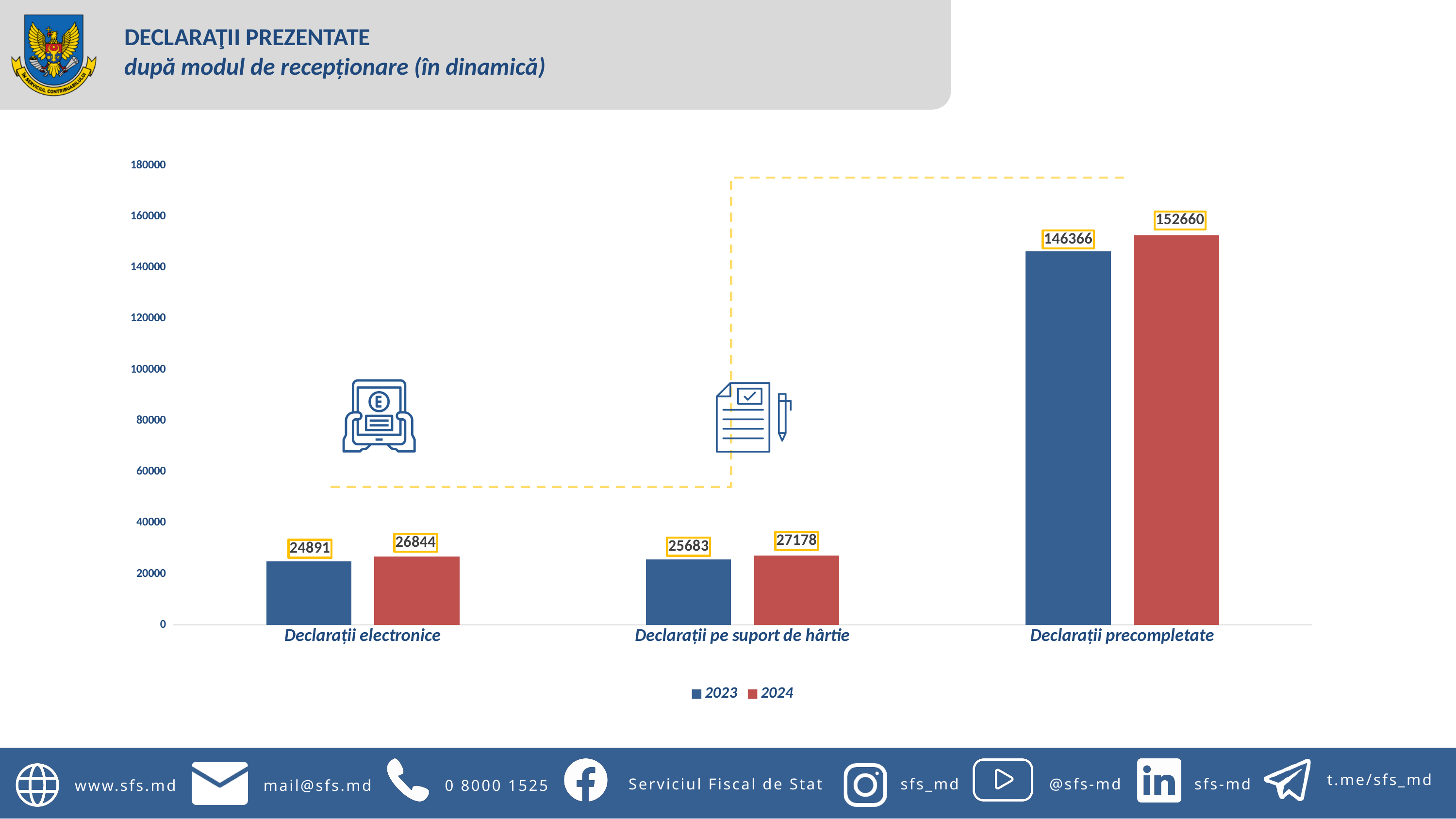
How many series does the legend list? 2 What is the value for Declarații precompletate in 2024? 152660 How many categories are shown on the x axis? 3 Which category has the highest value in 2023? Declarații precompletate What is the value for Declarații electronice in 2023? 24891 Which colour represents the 2024 series in the legend? Red What is the difference between the 2024 and 2023 values for Declarații electronice? 1953 What is the difference between the 2024 and 2023 values for Declarații precompletate? 6294 Which category has the lowest value in 2024? Declarații electronice Which is larger: the 2023 value for Declarații electronice or the 2023 value for Declarații pe suport de hârtie? Declarații pe suport de hârtie What is the value for Declarații pe suport de hârtie in 2024? 27178 What kind of chart is shown on the slide? Bar chart